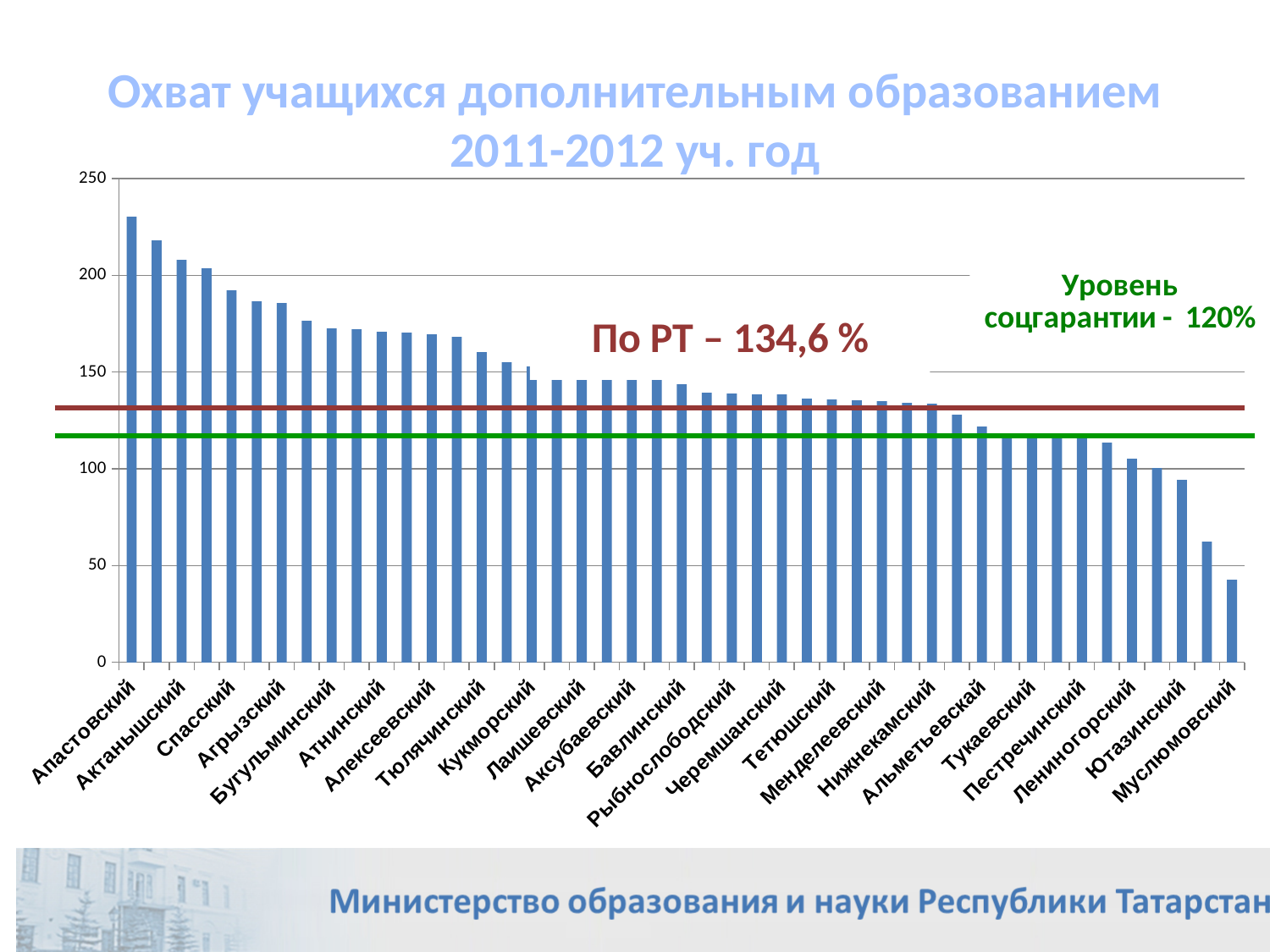
What is the social guarantee level (Уровень соцгарантии) marked on the chart? 120% Is the value for Тетюшский greater or less than 150? less Is the value for Апастовский greater or less than 200? greater Do the values rise or fall from left to right along the x axis? fall Is the value for Ютазинский greater or less than 100? less What value is given for the Republic of Tatarstan (По РТ) on the chart? 134,6 % What kind of chart is shown on the slide? bar chart Which district has the lowest value in the chart? Муслюмовский Which district has the highest value in the chart? Апастовский Which is larger, the value for Апастовский or the value for Муслюмовский? Апастовский